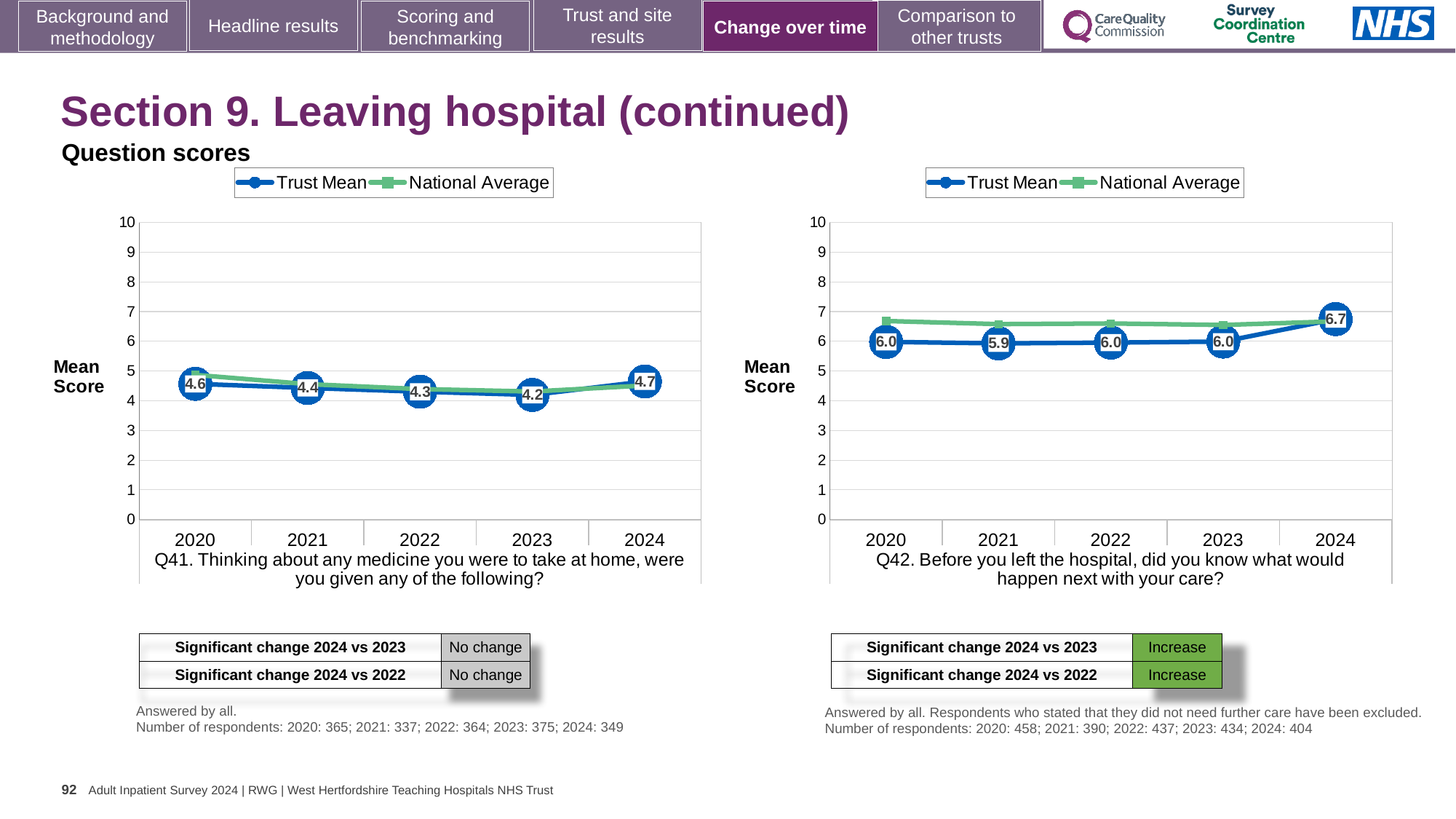
In the Q41 chart (left), what is the Trust Mean score for 2024? 4.7 What type of chart is the Q41 chart (left)? Line chart How many series does the legend of the Q42 chart (right) list? 2 In the Q42 chart (right), is the National Average for 2020 greater or less than 6? greater In the Q42 chart (right), what is the difference between the Trust Mean scores for 2024 and 2022? 0.7 How many years are plotted on the x axis of the Q41 chart (left)? 5 In the Q41 chart (left), which year has the lowest Trust Mean score? 2023 In the Q42 chart (right), what is the Trust Mean score for 2021? 5.9 In the Q42 chart (right), what is the Trust Mean score for 2024? 6.7 In the Q41 chart (left), what is the difference between the Trust Mean scores for 2024 and 2023? 0.5 In the Q42 chart (right), which year has the highest Trust Mean score? 2024 In the Q41 chart (left), what is the Trust Mean score for 2021? 4.4